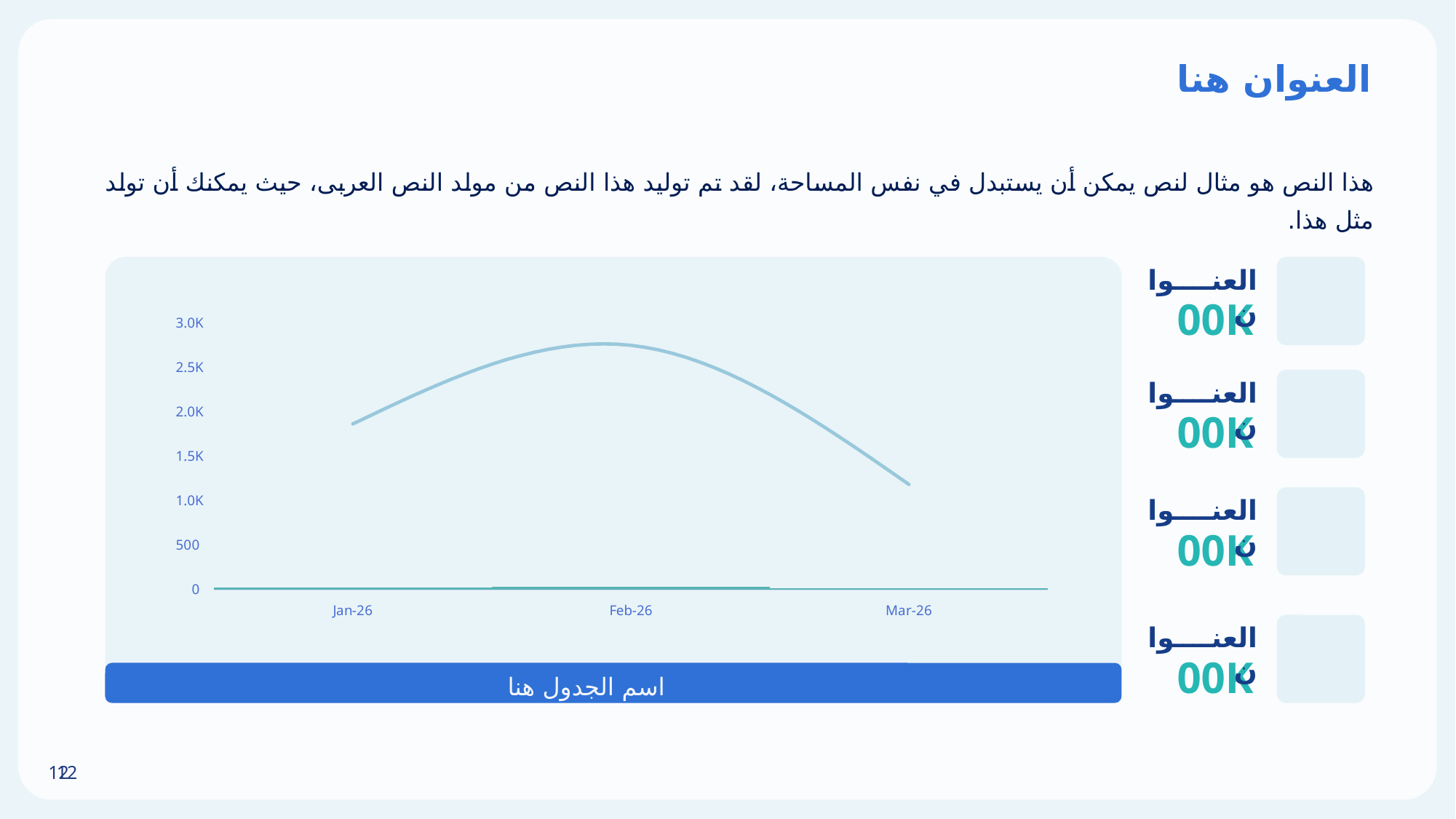
Is the value for Mar-26 greater or less than 1.5K? less What are the labels on the x axis of the chart, from left to right? Jan-26, Feb-26, Mar-26 Is the value for Feb-26 greater or less than 2.5K? greater How many points are plotted along the x axis of the chart? 3 What kind of chart is shown on the slide? line chart Is the value for Jan-26 greater or less than 1.5K? greater Does the line rise or fall from Jan-26 to Feb-26? rise What is the highest tick label shown on the y axis of the chart? 3.0K Which is larger, the value for Jan-26 or the value for Mar-26? Jan-26 Does the line rise or fall from Feb-26 to Mar-26? fall Which month has the lowest value on the chart? Mar-26 Which month has the highest value on the chart? Feb-26